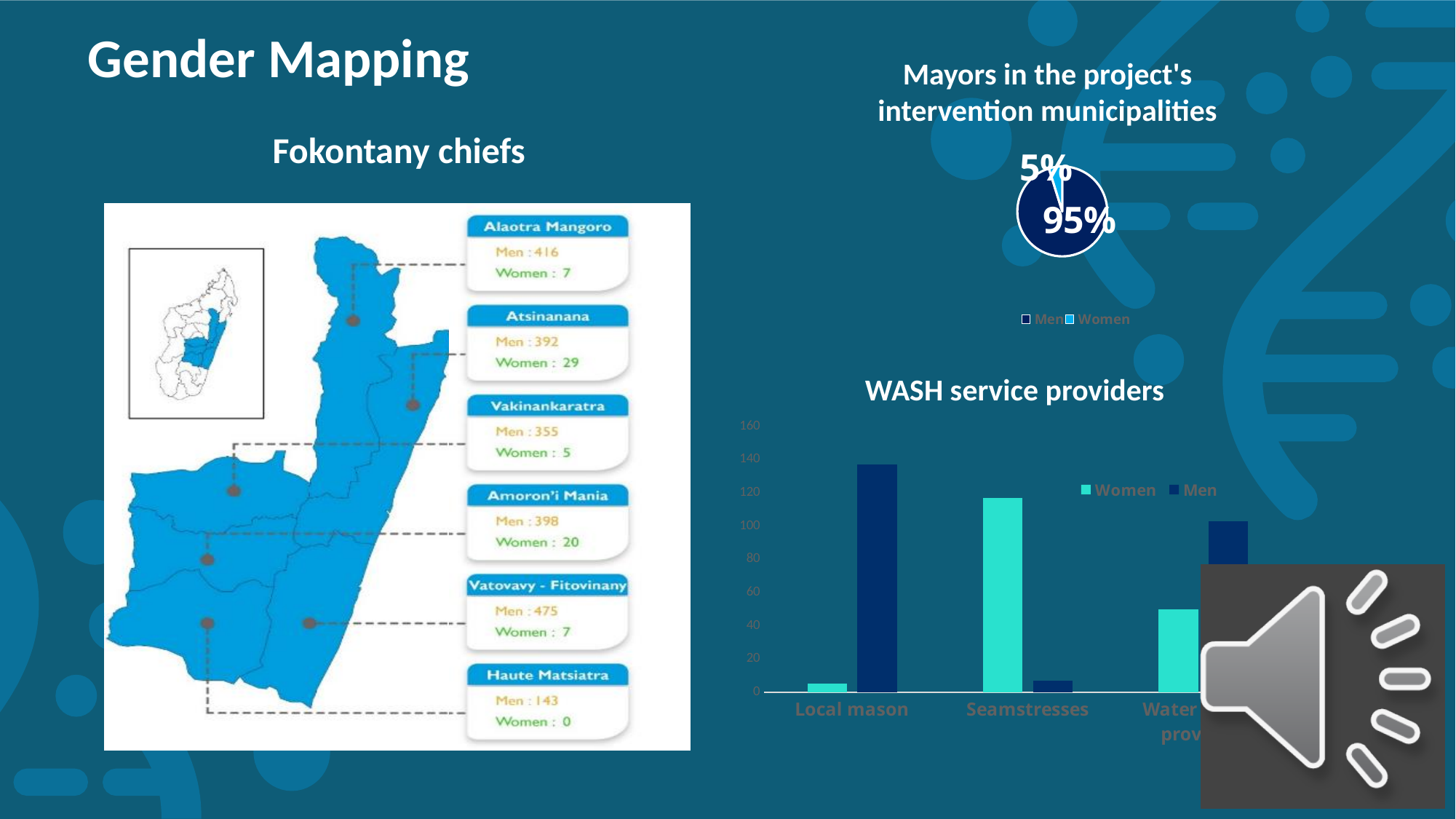
In the pie chart 'Mayors in the project's intervention municipalities', which slice is larger, Men or Women? Men In the 'WASH service providers' chart, which category has the highest Men value? Local mason How many series does the legend of the 'WASH service providers' chart list? 2 In the pie chart 'Mayors in the project's intervention municipalities', what share is labelled for Women? 5% In the 'WASH service providers' chart, for Seamstresses, which is larger, Women or Men? Women In the 'WASH service providers' chart, is the Women value for Seamstresses greater or less than 100? greater What kind of chart is 'WASH service providers'? bar chart In the pie chart 'Mayors in the project's intervention municipalities', what share is labelled for Men? 95% In the 'WASH service providers' chart, is the Women value for Local mason greater or less than 20? less What kind of chart is 'Mayors in the project's intervention municipalities'? pie chart In the 'WASH service providers' chart, is the Men value for Local mason greater or less than 120? greater How many entries does the legend of the 'Mayors in the project's intervention municipalities' chart list? 2